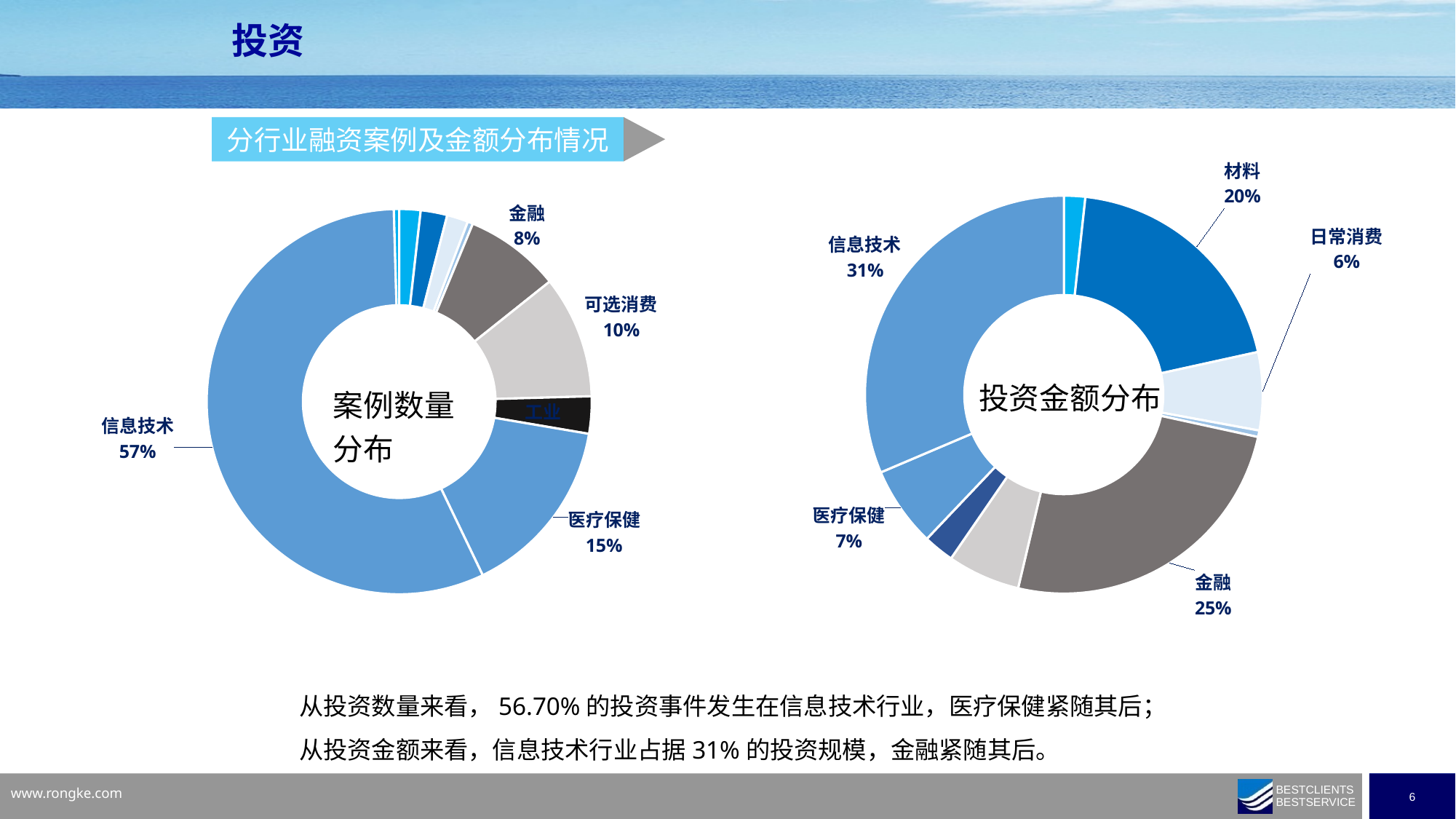
In the 投资金额分布 chart on the right, what is the value for 材料? 20% What type of chart is used for the 投资金额分布 chart on the right? Donut (pie) chart In the 投资金额分布 chart on the right, which labeled category has the largest share? 信息技术 In the 投资金额分布 chart on the right, what is the difference between the shares of 信息技术 and 金融? 6% In the 案例数量分布 chart on the left, which is larger, 医疗保健 or 可选消费? 医疗保健 In the 案例数量分布 chart on the left, what is the value for 可选消费? 10% In the 案例数量分布 chart on the left, what is the value for 医疗保健? 15% In the 投资金额分布 chart on the right, what share does 金融 hold? 25% In the 案例数量分布 chart on the left, which labeled category has the largest share? 信息技术 In the 案例数量分布 chart on the left, what is the value for 金融? 8% In the 案例数量分布 chart on the left, what share does 信息技术 hold? 57% In the 投资金额分布 chart on the right, what is the value for 日常消费? 6%